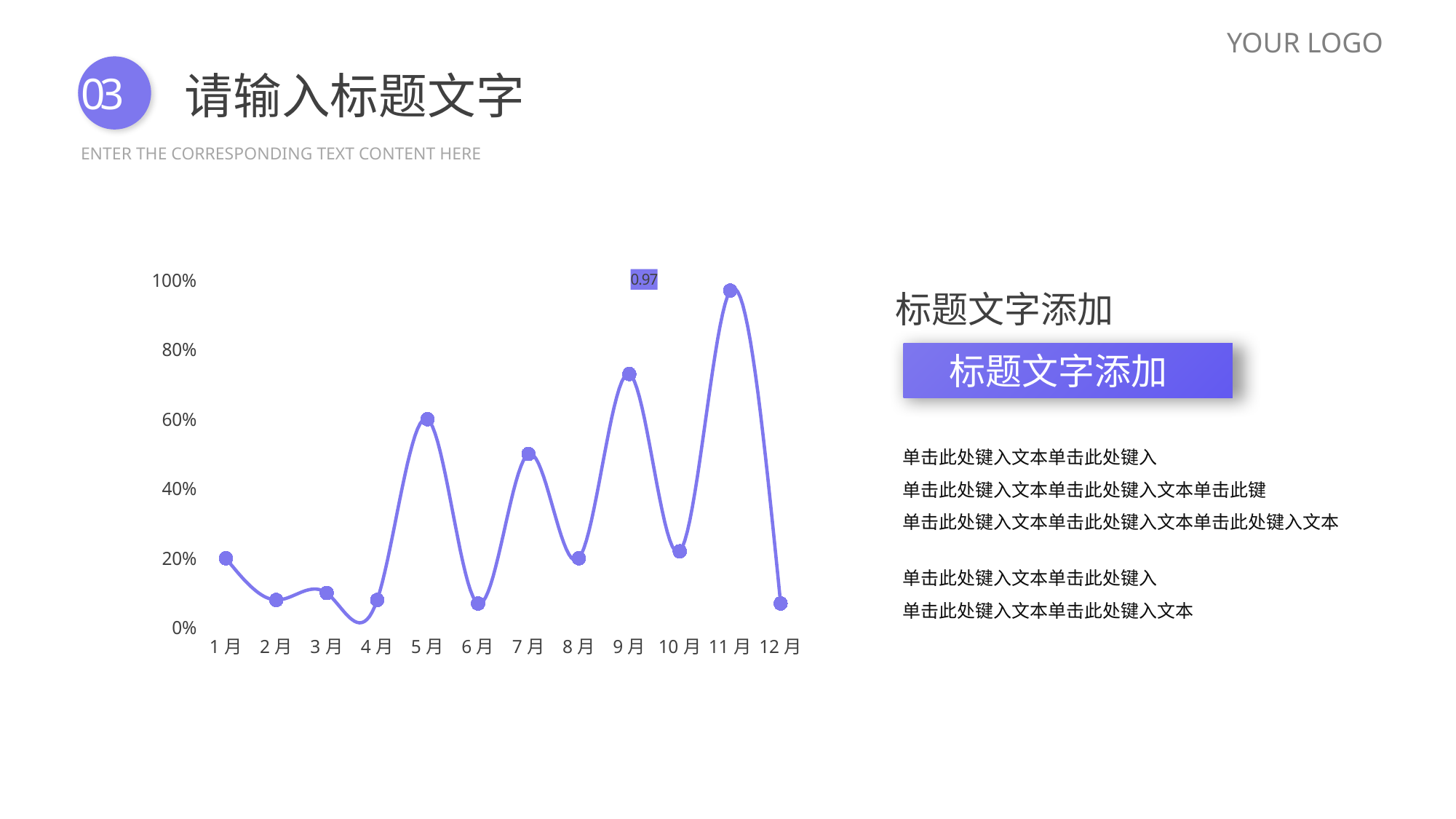
Does the value rise or fall from 11月 to 12月? fall Is the value for 9月 greater or less than 60%? greater Which month has the larger value, 9月 or 5月? 9月 How many months are plotted on the x axis of the chart? 12 Is the value for 11月 greater or less than 80%? greater Is the value for 12月 greater or less than 20%? less What kind of chart is shown on the slide? line chart Which month has the larger value, 5月 or 7月? 5月 Which month has the highest value in the chart? 11月 Does the value rise or fall from 4月 to 5月? rise